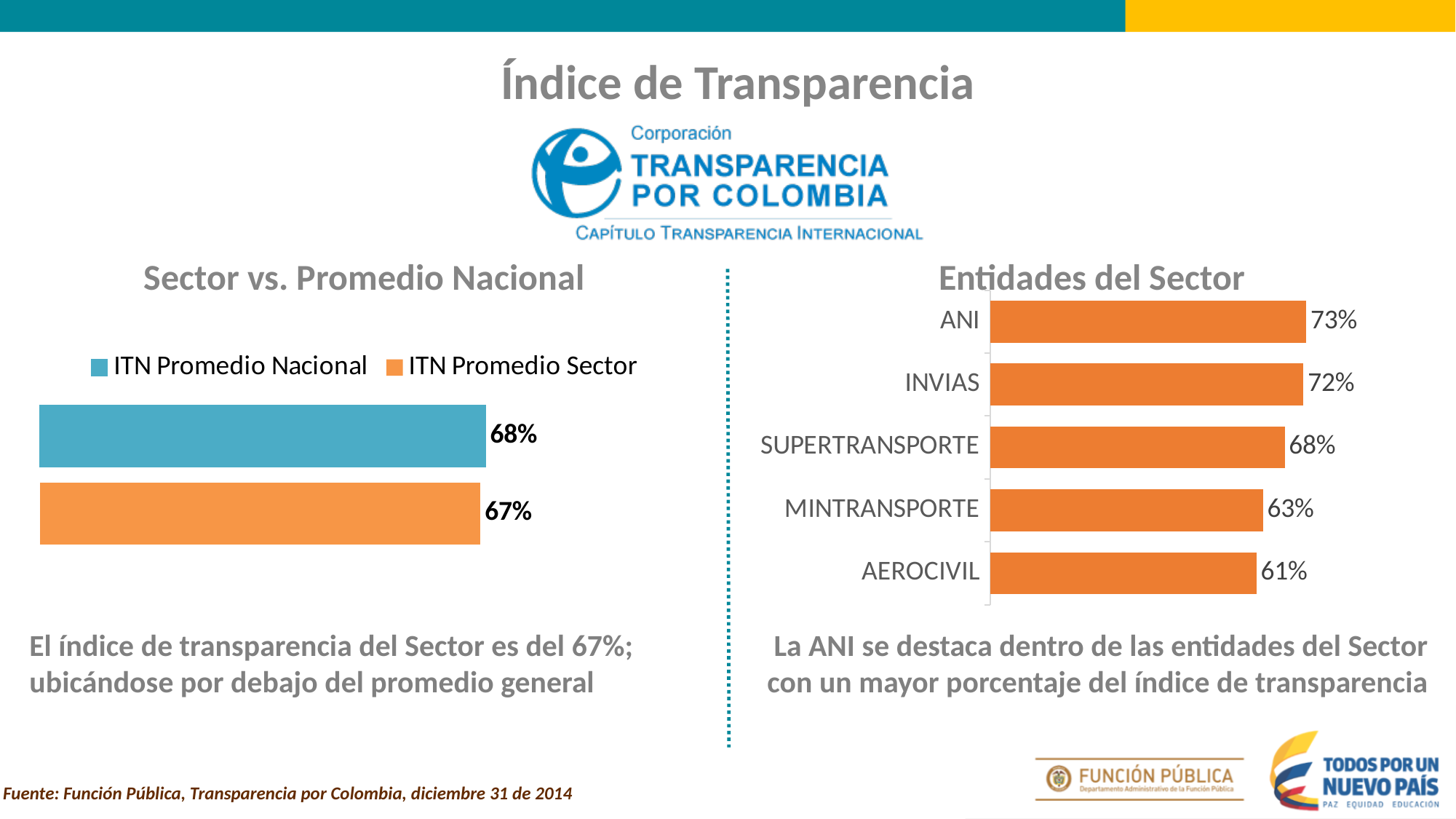
In the 'Entidades del Sector' chart, what is the difference between ANI and AEROCIVIL? 12% In the 'Entidades del Sector' chart, how many entities are shown? 5 In the 'Entidades del Sector' chart, which entity has the lowest value? AEROCIVIL In the 'Sector vs. Promedio Nacional' chart, how many series does the legend list? 2 In the 'Sector vs. Promedio Nacional' chart, what is the value for ITN Promedio Sector? 67% In the 'Entidades del Sector' chart, what is the value for MINTRANSPORTE? 63% In the 'Sector vs. Promedio Nacional' chart, what colour is the ITN Promedio Sector bar? Orange In the 'Sector vs. Promedio Nacional' chart, what is the difference between ITN Promedio Nacional and ITN Promedio Sector? 1% What kind of chart is the 'Entidades del Sector' chart? Bar chart In the 'Entidades del Sector' chart, what is the value for INVIAS? 72% In the 'Sector vs. Promedio Nacional' chart, what is the value for ITN Promedio Nacional? 68% In the 'Entidades del Sector' chart, which entity has the highest value? ANI